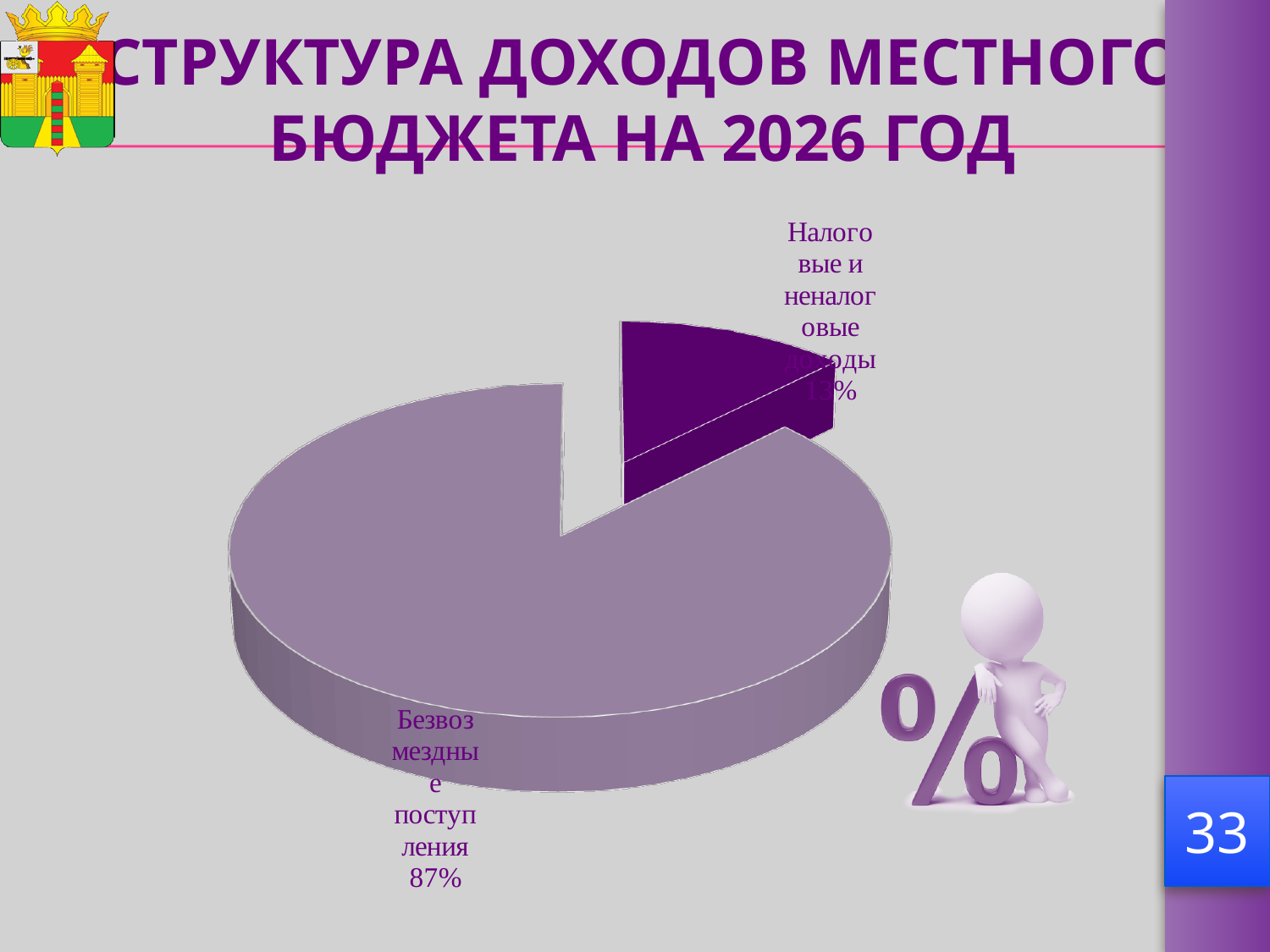
What is the difference in percentage points between "Безвозмездные поступления" and "Налоговые и неналоговые доходы"? 74 percentage points Is the share of "Безвозмездные поступления" greater or less than 50%? greater Which slice of the pie chart is the largest? Безвозмездные поступления What kind of chart is shown on the slide? Pie chart Which slice of the pie chart is the smallest? Налоговые и неналоговые доходы What is the title of the slide containing the pie chart? СТРУКТУРА ДОХОДОВ МЕСТНОГО БЮДЖЕТА НА 2026 ГОД What share of the pie does "Безвозмездные поступления" have? 87% What share of the pie does "Налоговые и неналоговые доходы" have? 13% Which is larger: the share of "Безвозмездные поступления" or the share of "Налоговые и неналоговые доходы"? Безвозмездные поступления Which year does the chart's title refer to? 2026 How many slices does the pie chart have? 2